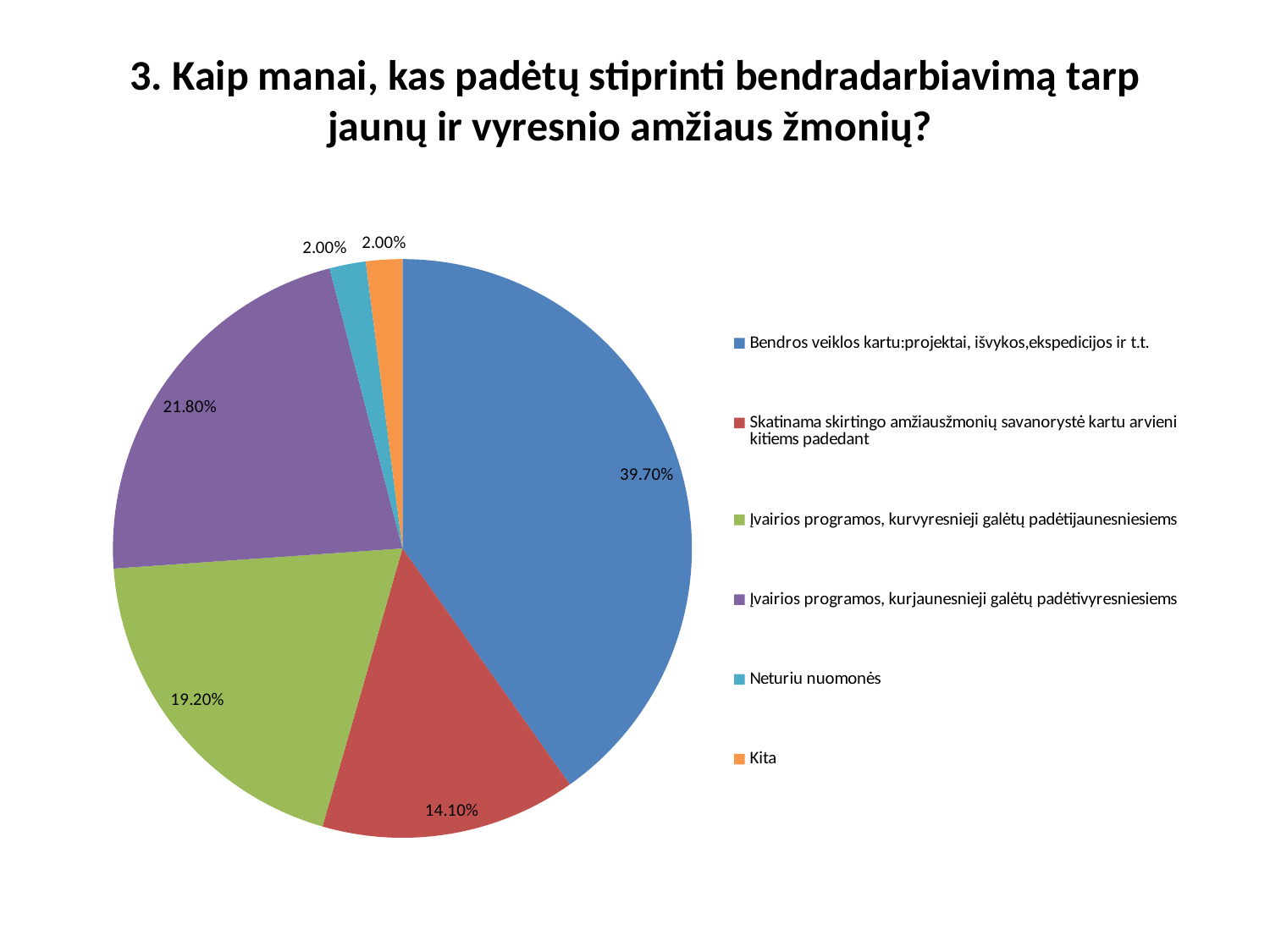
What percentage is shown for "Skatinama skirtingo amžiaus žmonių savanorystė kartu arvieni kitiems padedant"? 14.10% What is the difference in percentage points between the "Įvairios programos, kur jaunesnieji galėtų padėti vyresniesiems" slice and the "Neturiu nuomonės" slice? 19.80% What share of the pie is labelled for "Bendros veiklos kartu:projektai, išvykos,ekspedicijos ir t.t."? 39.70% What percentage is shown for "Neturiu nuomonės"? 2.00% What colour is the slice for "Kita"? orange Which category has the largest slice of the pie? Bendros veiklos kartu:projektai, išvykos,ekspedicijos ir t.t. What percentage is shown for "Įvairios programos, kur jaunesnieji galėtų padėti vyresniesiems"? 21.80% What percentage is shown for "Įvairios programos, kur vyresnieji galėtų padėti jaunesniesiems"? 19.20% Which is larger: the slice for "Įvairios programos, kur jaunesnieji galėtų padėti vyresniesiems" or the slice for "Įvairios programos, kur vyresnieji galėtų padėti jaunesniesiems"? Įvairios programos, kur jaunesnieji galėtų padėti vyresniesiems What kind of chart is shown on the slide? pie chart What is the difference in percentage points between the "Bendros veiklos kartu" slice and the "Skatinama skirtingo amžiaus žmonių savanorystė" slice? 25.60% How many slices does the pie chart have? 6